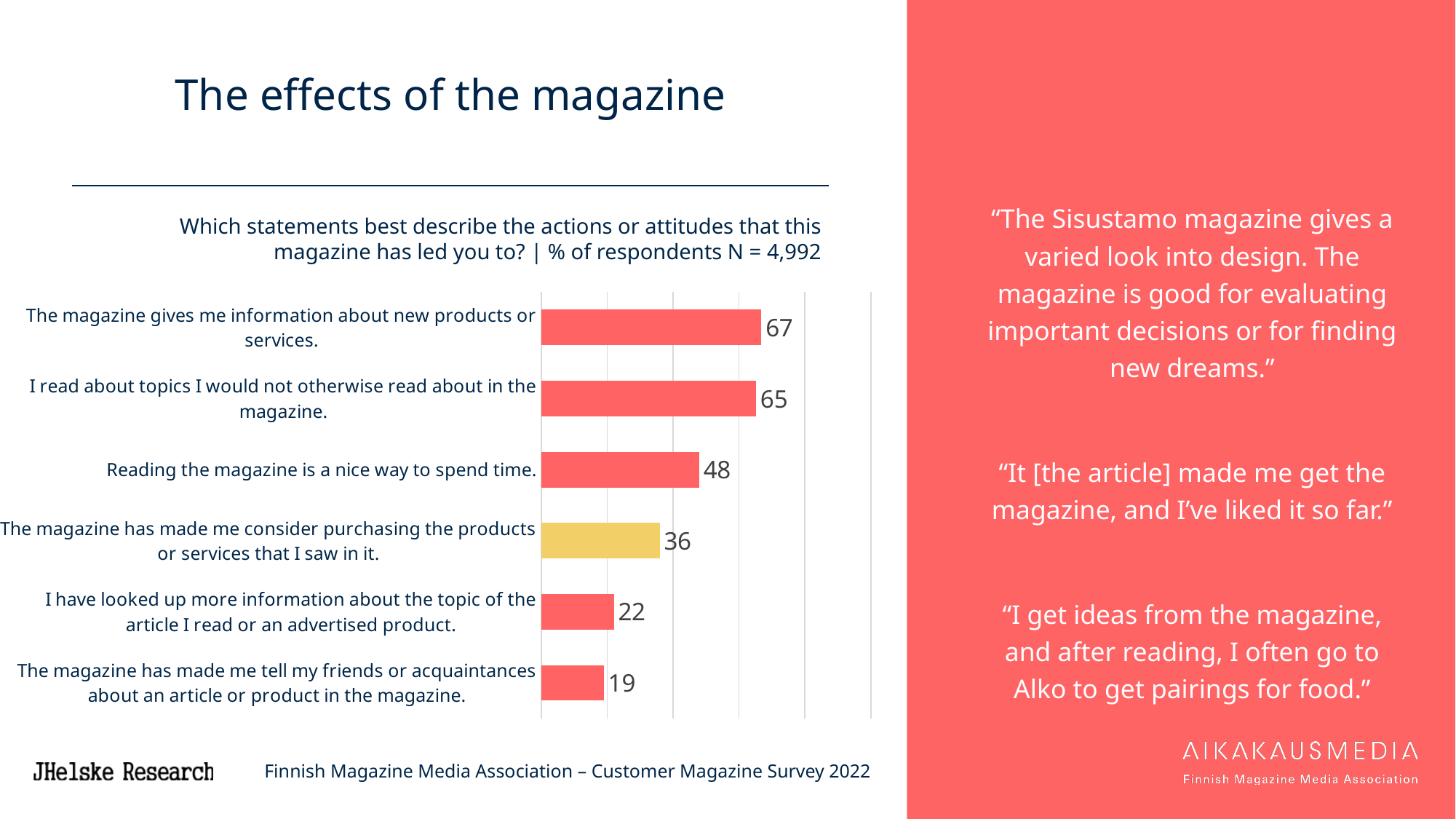
What is the value for "Reading the magazine is a nice way to spend time."? 48 What percentage of respondents said the magazine gives them information about new products or services? 67 What is the value for "The magazine has made me consider purchasing the products or services that I saw in it."? 36 How many statements are shown in the chart? 6 Which statement has the lowest value in the chart? The magazine has made me tell my friends or acquaintances about an article or product in the magazine. What is the number of respondents (N) stated in the chart's subtitle? 4,992 What is the difference between the value for "I read about topics I would not otherwise read about in the magazine." and the value for "Reading the magazine is a nice way to spend time."? 17 What kind of chart is shown on the slide? Bar chart Which statement has the highest value in the chart? The magazine gives me information about new products or services. Which is larger: the value for "I have looked up more information about the topic of the article I read or an advertised product." or the value for "The magazine has made me tell my friends or acquaintances about an article or product in the magazine."? I have looked up more information about the topic of the article I read or an advertised product. Which bar in the chart is coloured yellow rather than red? The magazine has made me consider purchasing the products or services that I saw in it. What is the difference between the highest and lowest values in the chart? 48